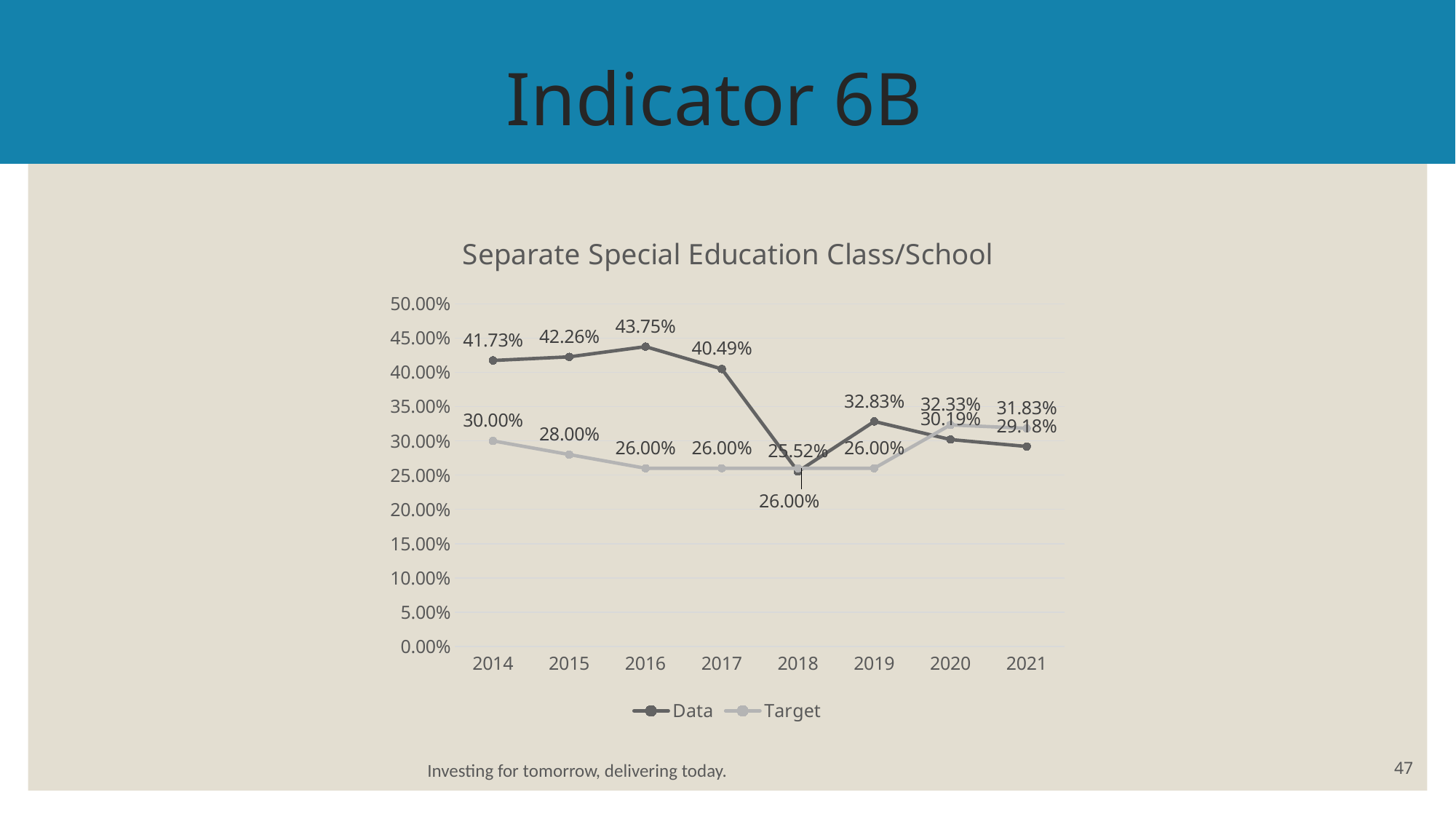
What type of chart is shown on the slide? Line chart What is the Data value for 2016? 43.75% Which is larger in 2021, the Data value or the Target value? Target What is the difference between the Data value in 2017 and the Data value in 2018? 14.97% What is the Target value for 2015? 28.00% In which year is the Data series highest? 2016 Does the Data series rise or fall from 2019 to 2021? Fall What is the Data value for 2018? 25.52% In which year is the Data series lowest? 2018 What is the title of the chart? Separate Special Education Class/School How many years are shown on the x axis? 8 How many series does the legend list? 2